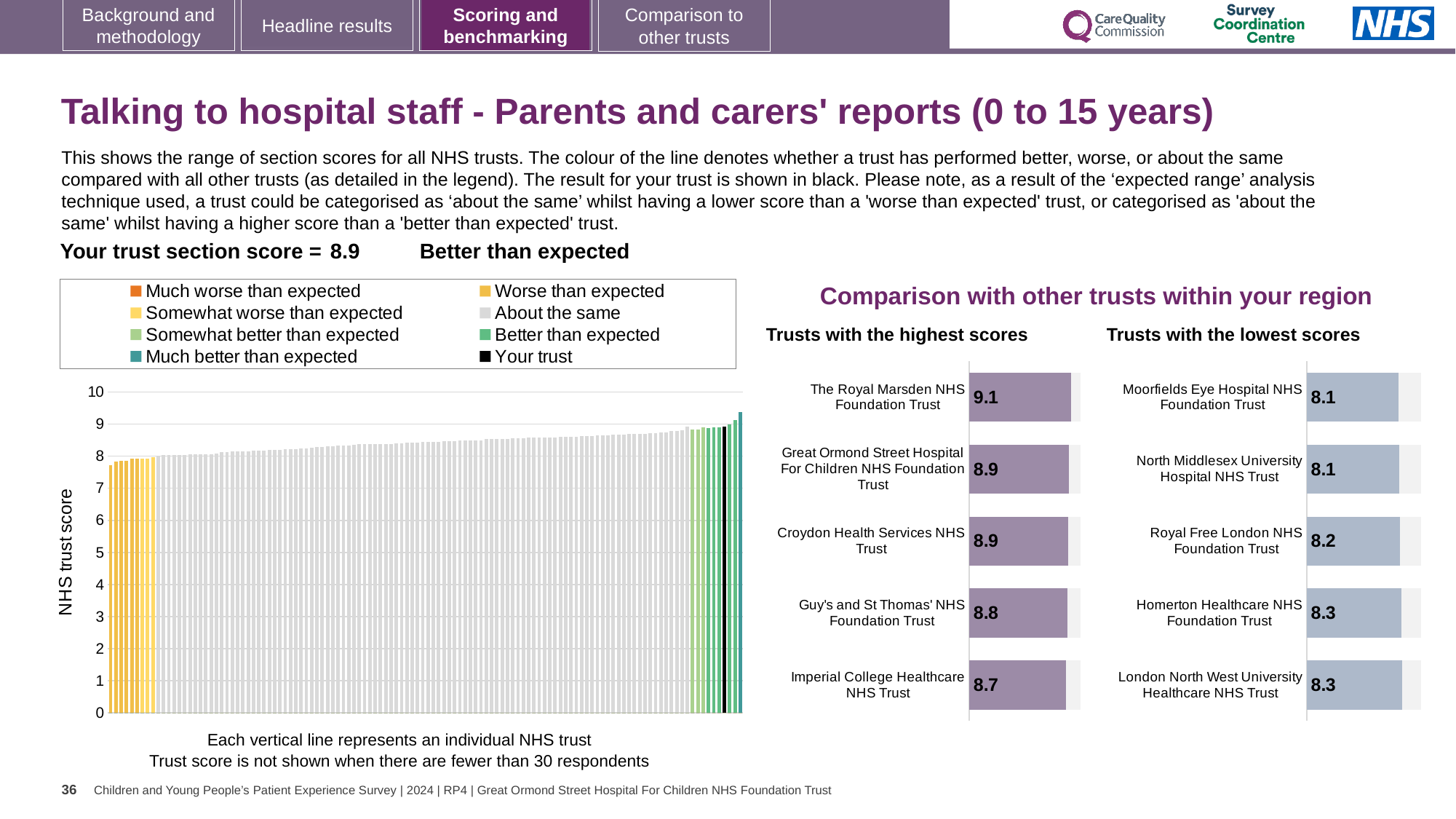
How many trusts are shown in the 'Trusts with the lowest scores' chart? 5 In the 'Trusts with the highest scores' chart, what is the score for Imperial College Healthcare NHS Trust? 8.7 In the 'Trusts with the lowest scores' chart, what is the score for Royal Free London NHS Foundation Trust? 8.2 In the 'Trusts with the lowest scores' chart, what is the score for Homerton Healthcare NHS Foundation Trust? 8.3 How many entries does the legend of the NHS trust score chart list? 8 In the 'Trusts with the highest scores' chart, which trust has the lowest score? Imperial College Healthcare NHS Trust In the 'Trusts with the highest scores' chart, what is the difference between the scores of The Royal Marsden NHS Foundation Trust and Imperial College Healthcare NHS Trust? 0.4 In the 'Trusts with the highest scores' chart, which trust has the highest score? The Royal Marsden NHS Foundation Trust What kind of chart is the NHS trust score chart on the left of the slide? Bar chart In the 'Trusts with the highest scores' chart, what is the score for The Royal Marsden NHS Foundation Trust? 9.1 Which is larger: the score for Guy's and St Thomas' NHS Foundation Trust in the highest scores chart, or the score for Royal Free London NHS Foundation Trust in the lowest scores chart? Guy's and St Thomas' NHS Foundation Trust In the 'Trusts with the lowest scores' chart, what is the difference between the scores of London North West University Healthcare NHS Trust and Moorfields Eye Hospital NHS Foundation Trust? 0.2